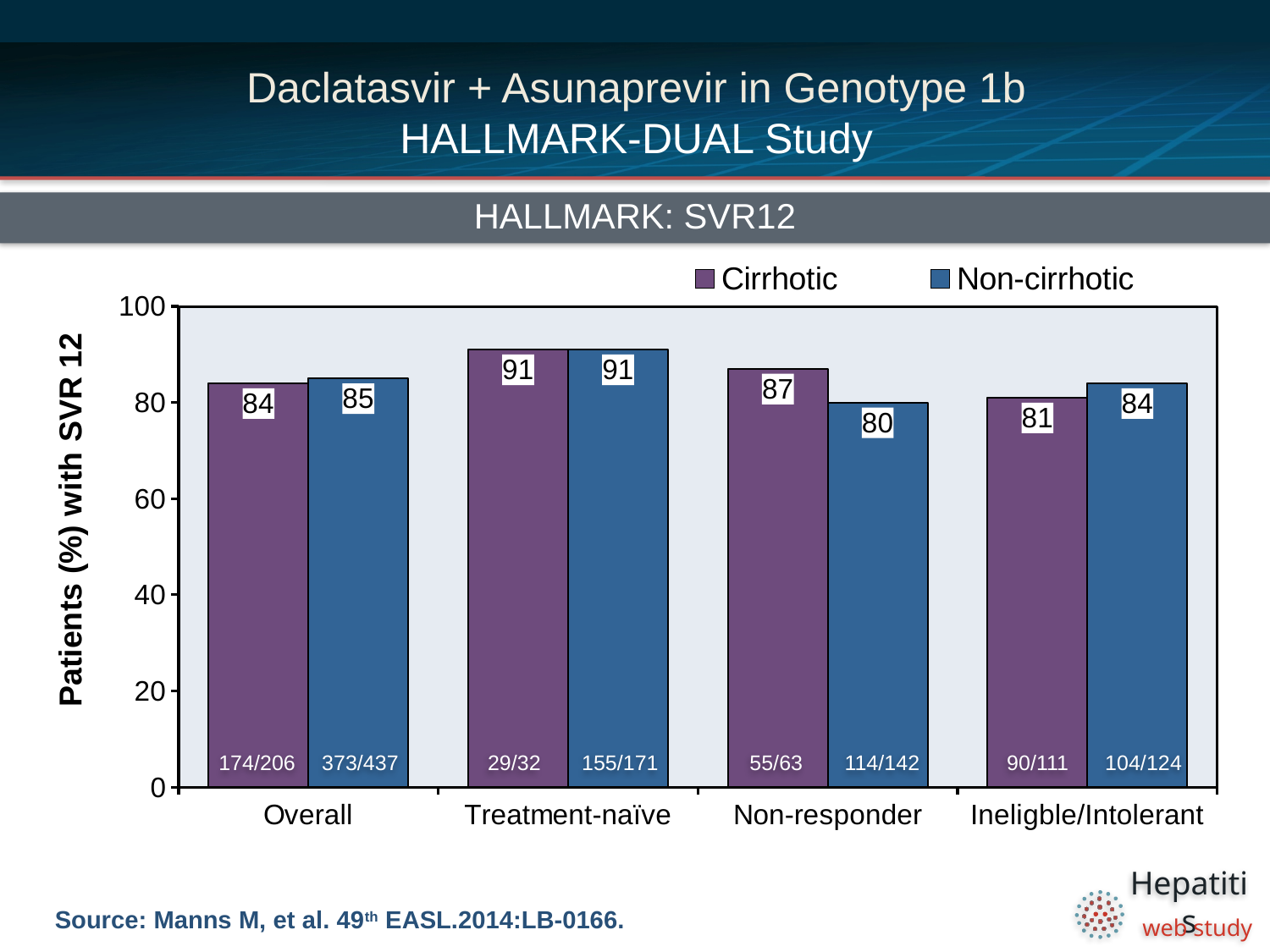
What fraction of patients is shown for Non-cirrhotic patients in the Treatment-naïve group? 155/171 What kind of chart is shown on the slide? Bar chart How many patient categories are shown on the x axis? 4 What is the SVR12 rate for Non-cirrhotic patients in the Non-responder group? 80 What is the SVR12 rate for Cirrhotic patients in the Overall group? 84 In the Ineligble/Intolerant group, which is larger: the Cirrhotic or the Non-cirrhotic SVR12 rate? Non-cirrhotic What is the difference between the Cirrhotic and Non-cirrhotic SVR12 rates in the Non-responder group? 7 How many series does the legend list? 2 What is the label of the y axis? Patients (%) with SVR 12 What is the SVR12 rate for Cirrhotic patients in the Ineligble/Intolerant group? 81 Which category has the lowest SVR12 rate for Non-cirrhotic patients? Non-responder Which category has the highest SVR12 rate for Cirrhotic patients? Treatment-naïve